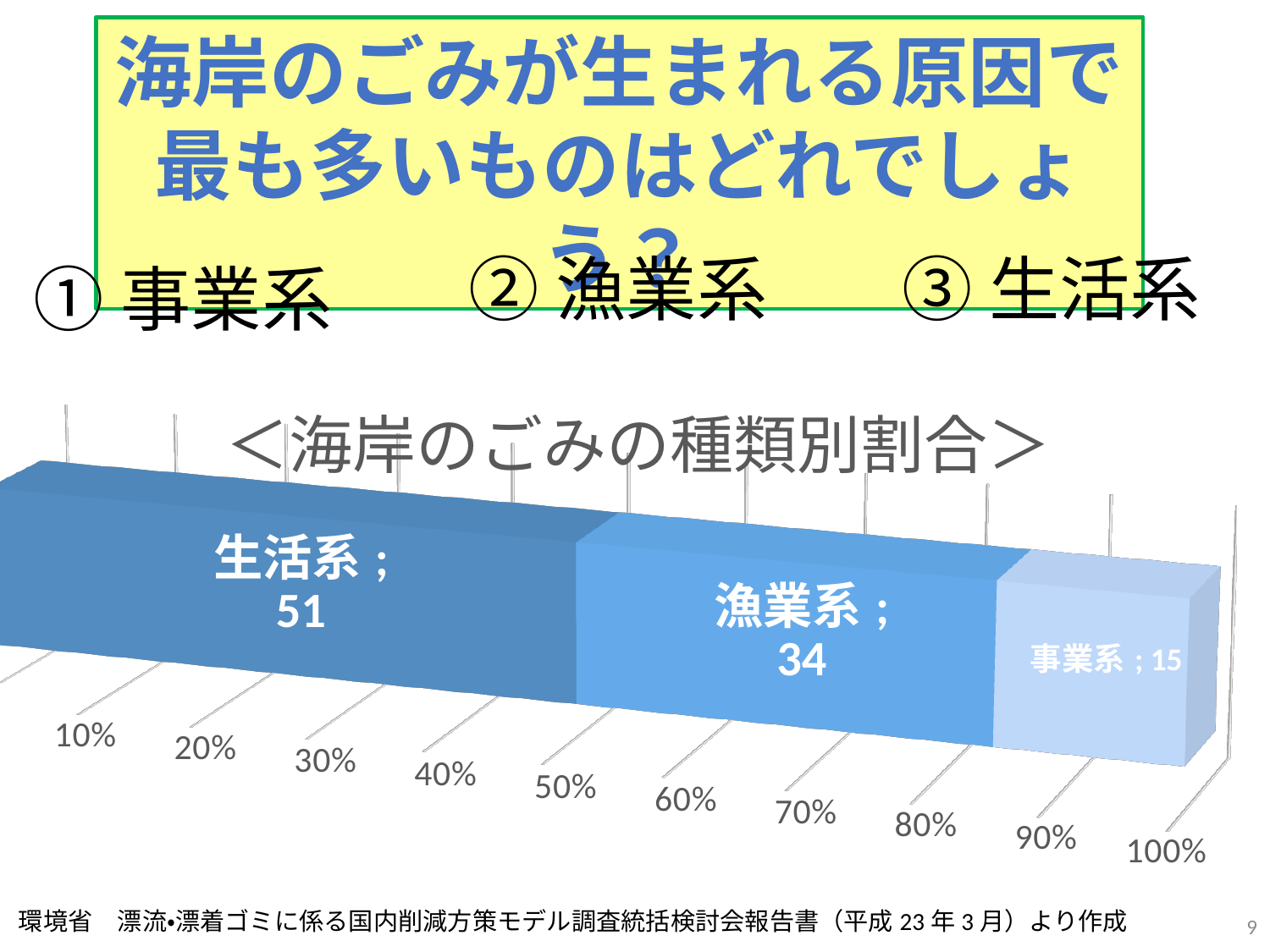
What is the value shown for 漁業系 in the chart? 34 What is the difference between the values for 漁業系 and 事業系? 19 What is the title of the chart? ＜海岸のごみの種類別割合＞ What is the difference between the values for 生活系 and 漁業系? 17 Which category has the smallest value in the chart? 事業系 What kind of chart is shown on the slide? Stacked bar chart Which category has the largest value in the chart? 生活系 How many categories (segments) are shown in the bar? 3 What is the value shown for 生活系 in the chart? 51 Which is larger, the value for 漁業系 or the value for 事業系? 漁業系 What is the value shown for 事業系 in the chart? 15 What is the total of the three segments in the stacked bar? 100